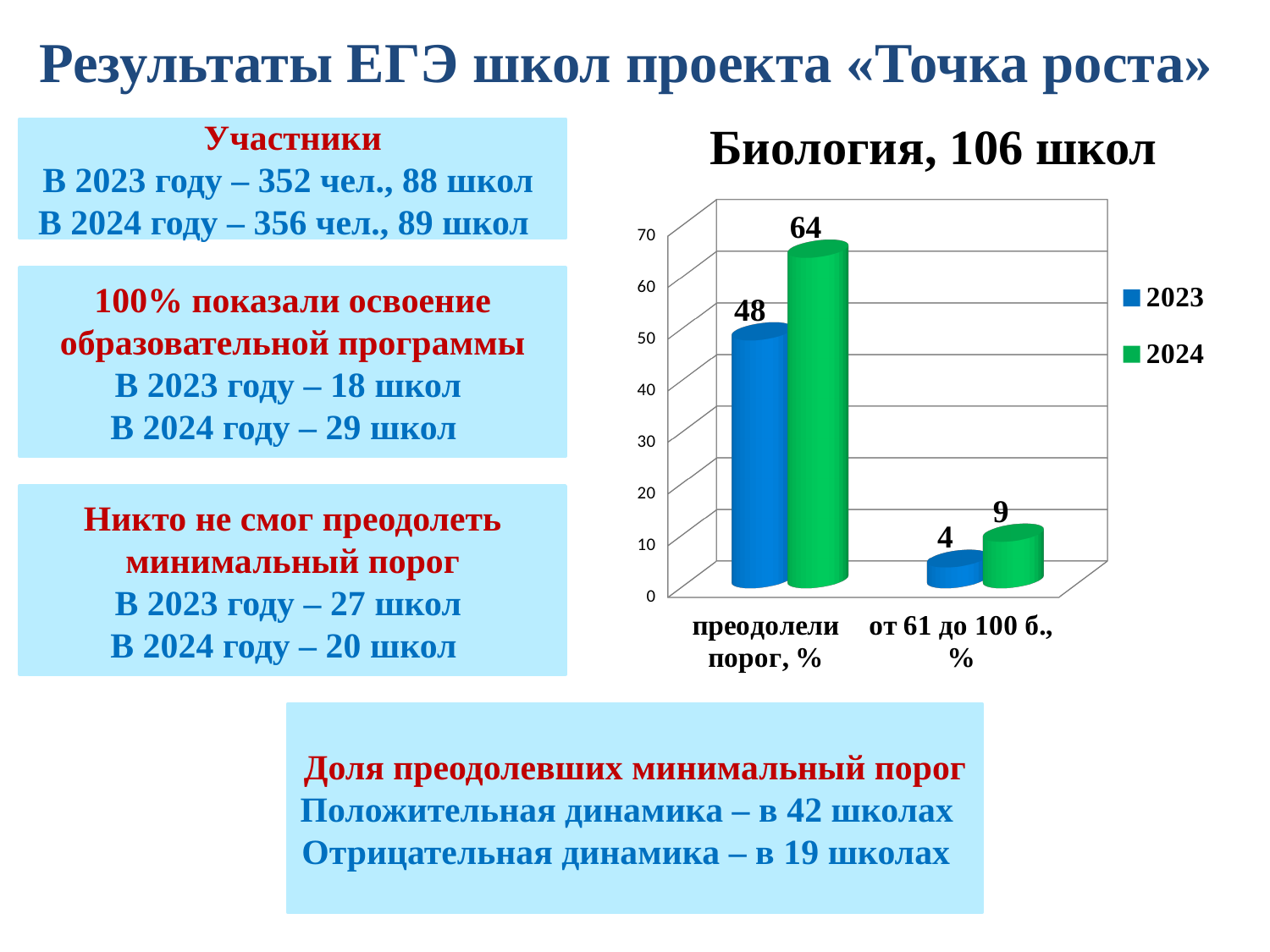
How many categories are shown on the x axis of the chart? 2 How many series does the chart legend list? 2 Which series has the higher value in the category "преодолели порог, %", 2023 or 2024? 2024 What is the title of the chart? Биология, 106 школ What is the value for 2023 in the category "преодолели порог, %"? 48 What kind of chart is shown on the slide? bar chart What is the difference between the 2024 and 2023 values in the category "преодолели порог, %"? 16 What is the difference between the 2024 and 2023 values in the category "от 61 до 100 б., %"? 5 What is the value for 2023 in the category "от 61 до 100 б., %"? 4 What is the value for 2024 in the category "преодолели порог, %"? 64 Which category has the lowest value for the 2023 series? от 61 до 100 б., % What is the value for 2024 in the category "от 61 до 100 б., %"? 9